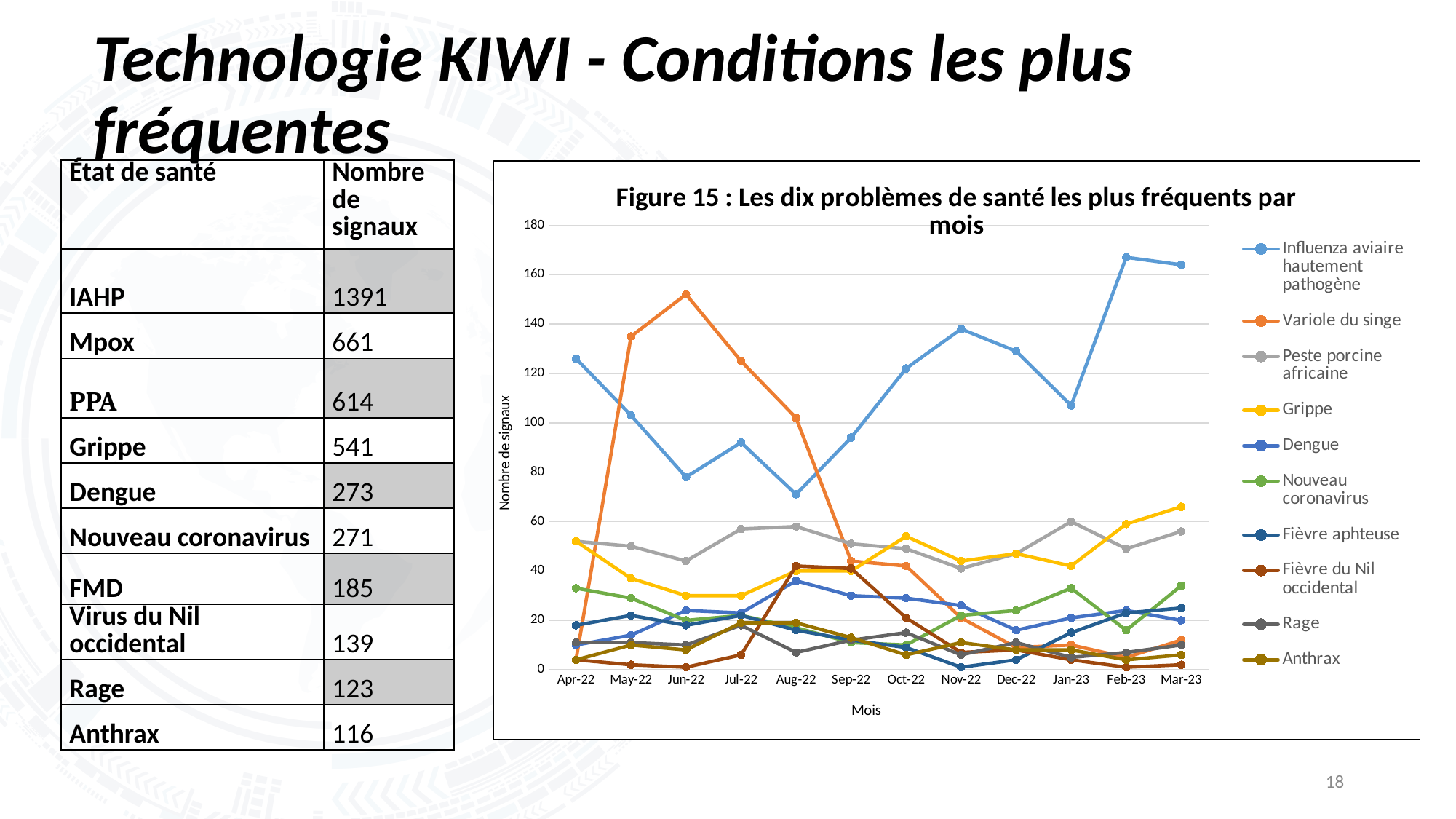
Which series has the lowest value in Nov-22? Fièvre aphteuse What is the label of the vertical axis of the chart? Nombre de signaux Does the Variole du singe series rise or fall from Jun-22 to Nov-22? fall In Apr-22, which series has the larger value: Influenza aviaire hautement pathogène or Variole du singe? Influenza aviaire hautement pathogène What kind of chart is shown on the slide? line chart Is the value for Grippe in Mar-23 greater or less than 60? greater What is the title of the chart? Figure 15 : Les dix problèmes de santé les plus fréquents par mois Is the value for Variole du singe in Jun-22 greater or less than 140? greater How many months are plotted along the x axis of the chart? 12 How many series does the legend of the chart list? 10 Is the value for Influenza aviaire hautement pathogène in Feb-23 greater or less than 160? greater Which series has the highest value in Jun-22? Variole du singe